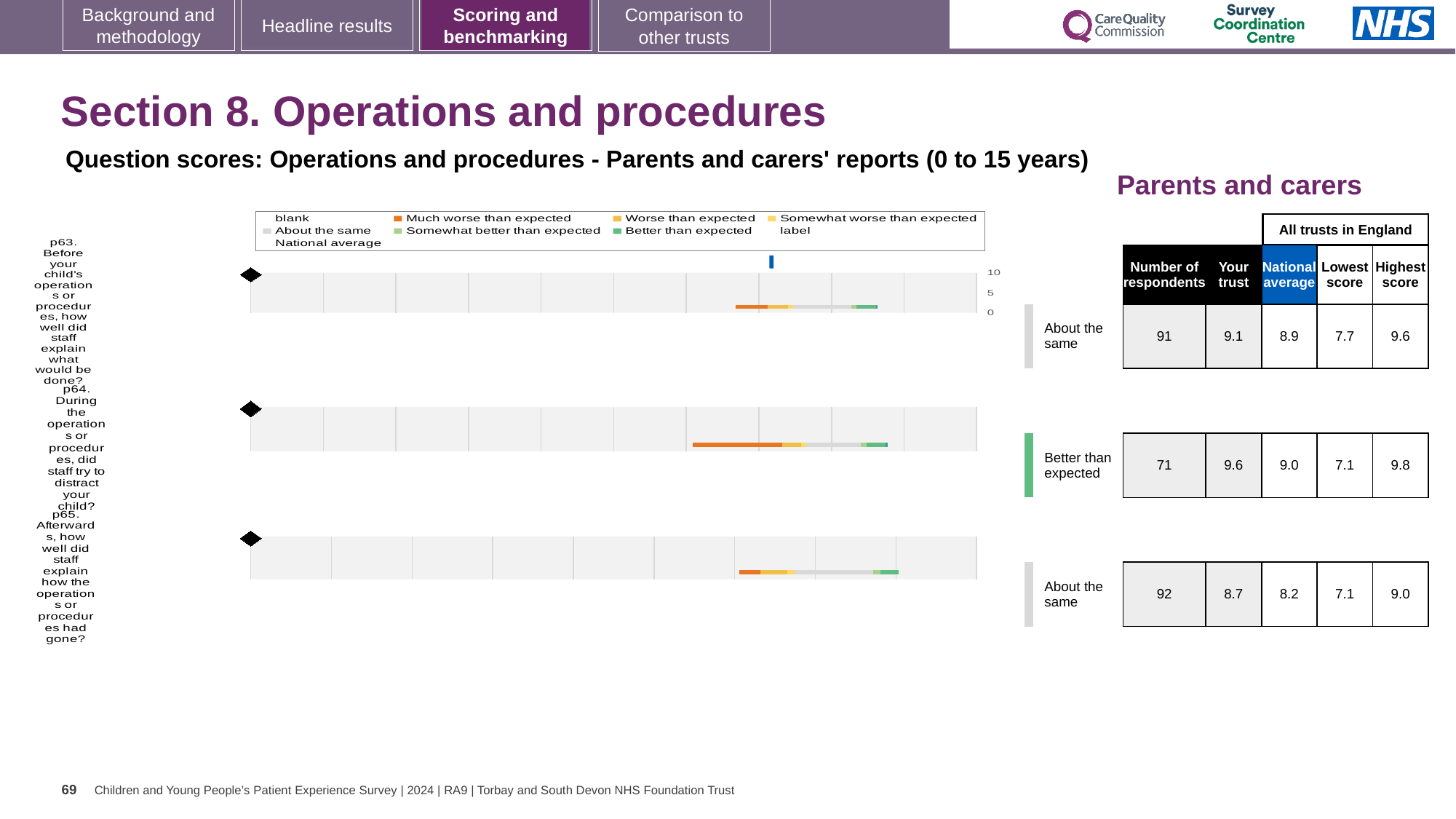
Which question has the lowest 'Your trust' score? p65 How many respondents answered p65 (Afterwards, how well did staff explain how the operations or procedures had gone?)? 92 For p65, what is the difference between the highest score and the lowest score across all trusts in England? 1.9 For p64, how much higher is the 'Your trust' score than the national average? 0.6 What is the lowest score across all trusts in England for p63? 7.7 For p63, which is larger: the 'Your trust' score or the national average? Your trust What is the highest score across all trusts in England for p64? 9.8 How many questions are shown in the Operations and procedures charts on this slide? 3 What benchmark category is shown for p64? Better than expected What is the national average score for p64 (During the operations or procedures, did staff try to distract your child?)? 9.0 Which question has the highest 'Your trust' score? p64 What is the 'Your trust' score for p63 (Before your child's operations or procedures, how well did staff explain what would be done?)? 9.1